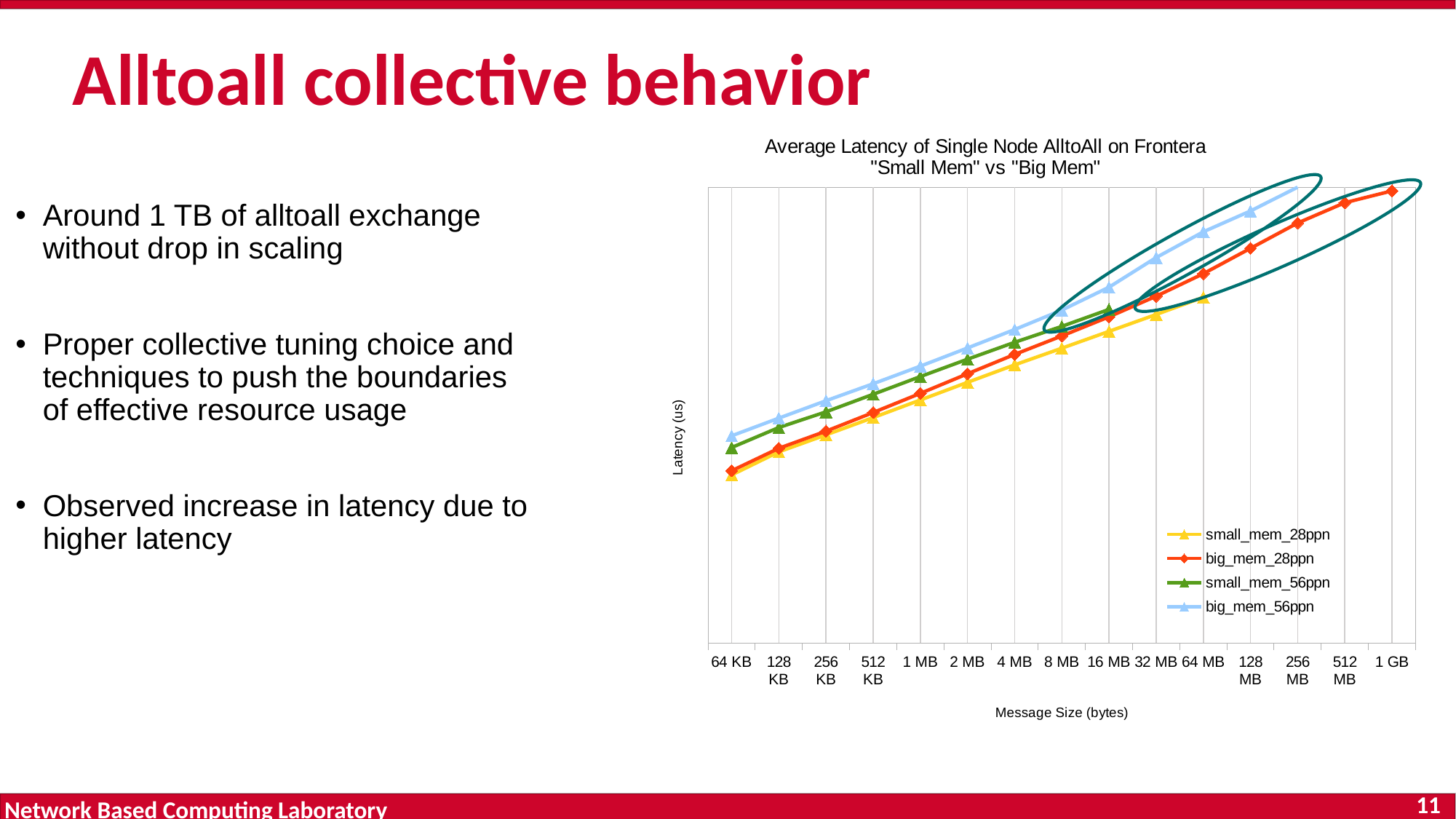
How many series does the legend list? 4 At 8 MB, which is larger: the latency for big_mem_56ppn or for big_mem_28ppn? big_mem_56ppn What is the label of the y axis? Latency (us) Which series has the highest latency at 64 KB? big_mem_56ppn Which series extends all the way to the 1 GB message size? big_mem_28ppn Which series has the highest latency at 1 MB? big_mem_56ppn How many message-size categories are shown on the x axis? 15 At 256 KB, which is larger: the latency for small_mem_56ppn or for big_mem_28ppn? small_mem_56ppn What kind of chart is shown on the slide? line chart Do the latency values rise or fall as message size increases along the x axis? rise At 1 MB, which is larger: the latency for big_mem_56ppn or for small_mem_28ppn? big_mem_56ppn